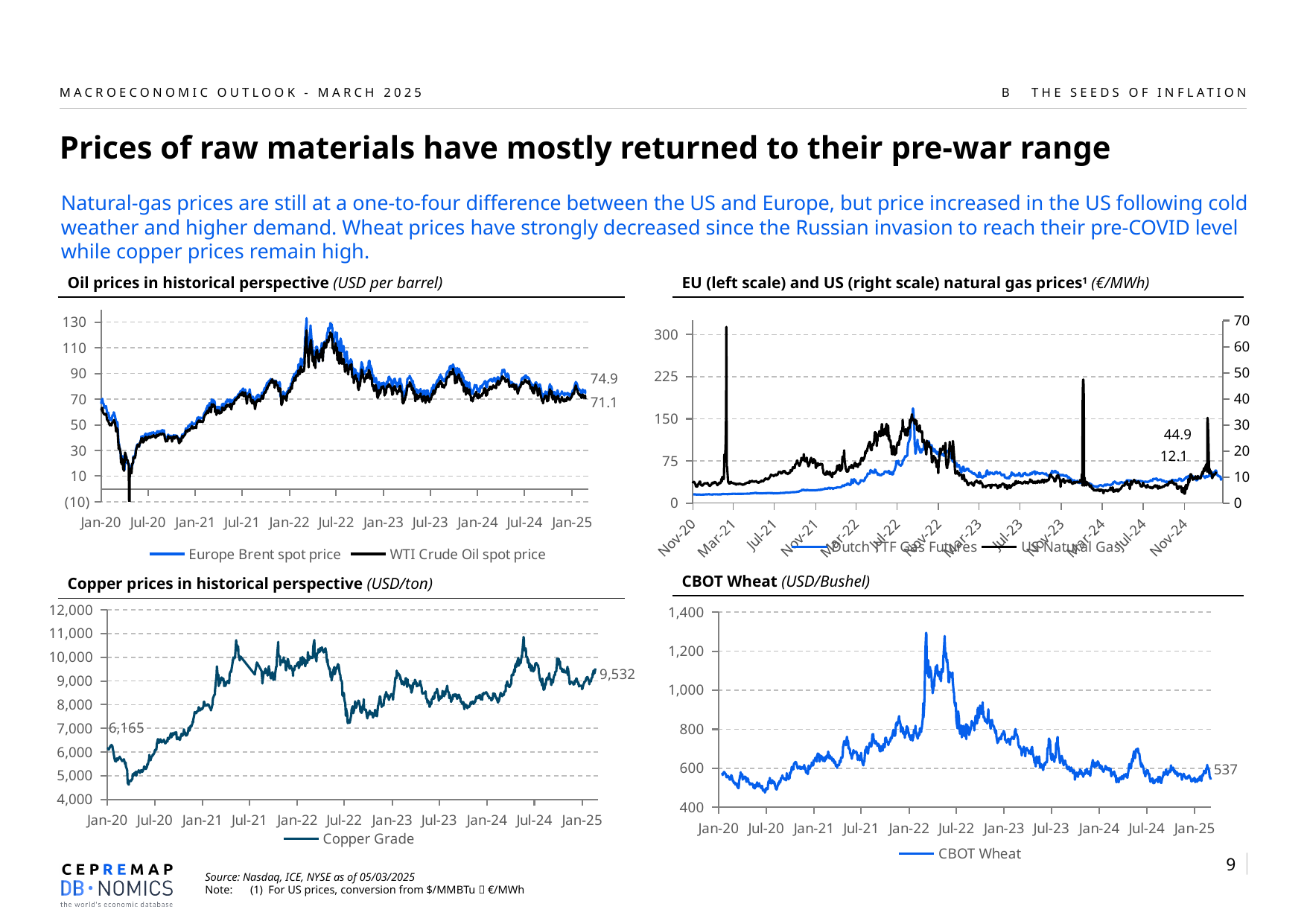
How many series does the legend of the 'Oil prices in historical perspective' chart list? 2 In the 'EU (left scale) and US (right scale) natural gas prices' chart, what is the latest value shown for Dutch TTF Gas Futures? 44.9 In the 'CBOT Wheat' chart, what is the latest value shown? 537 In the 'Copper prices in historical perspective' chart, by how much does the latest labelled value exceed the starting labelled value? 3,367 In the 'Oil prices in historical perspective' chart, what is the difference between the latest Brent value and the latest WTI value? 3.8 In the 'Copper prices in historical perspective' chart, what is the latest value shown for Copper Grade? 9,532 In the 'Oil prices in historical perspective' chart, what is the latest value shown for the Europe Brent spot price? 74.9 In the 'Copper prices in historical perspective' chart, what value is labelled at the start of the series in Jan-20? 6,165 In the 'Oil prices in historical perspective' chart, what is the latest value shown for the WTI Crude Oil spot price? 71.1 In the 'CBOT Wheat' chart, is the peak value reached in 2022 greater or less than 1,200? greater In the 'Oil prices in historical perspective' chart, which series has the higher latest value, Europe Brent or WTI Crude Oil? Europe Brent spot price What kind of chart is the 'CBOT Wheat' chart? Line chart